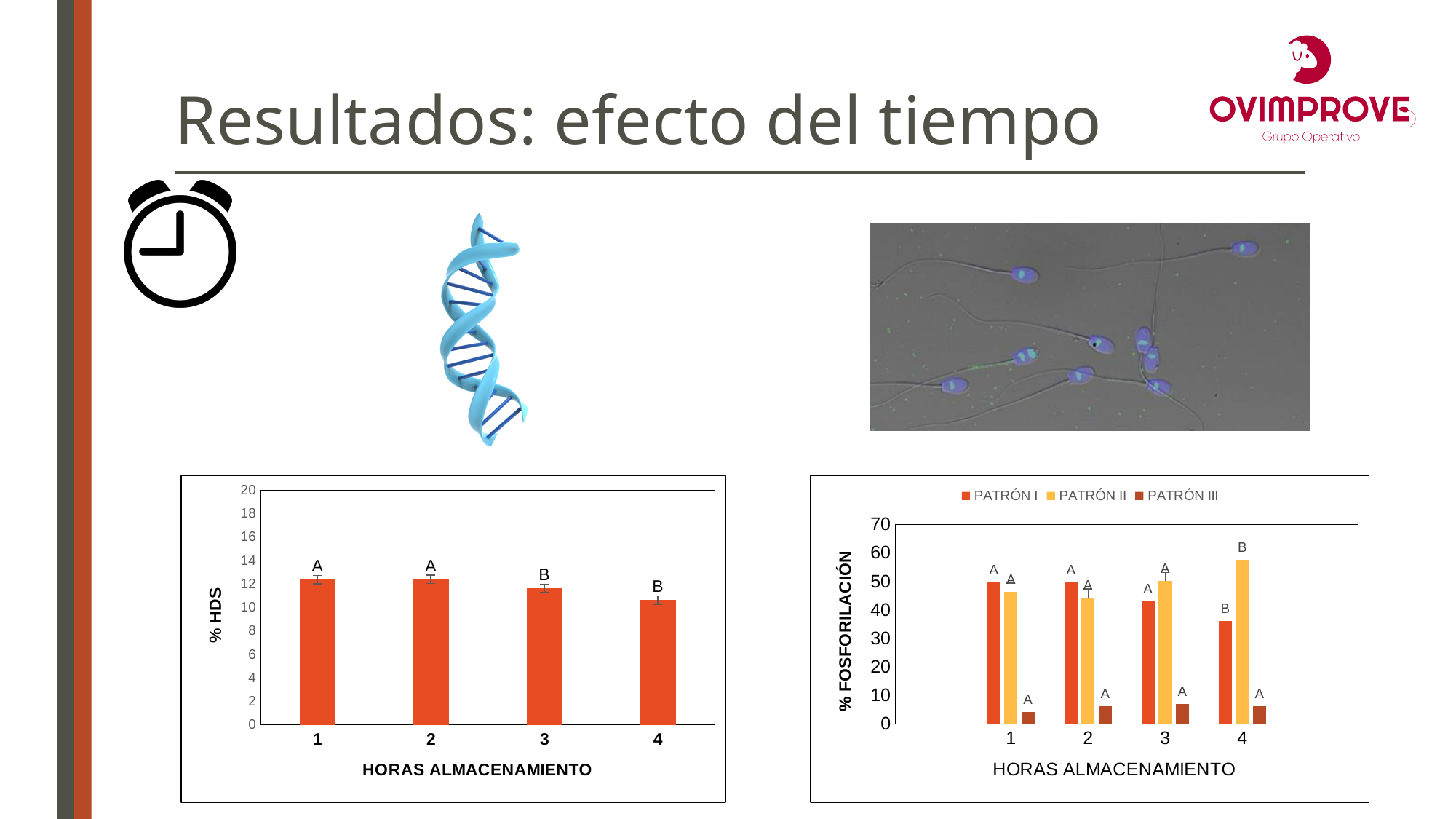
In the left chart (% HDS), is the value for hour 4 greater or less than 12? less What is the x axis title of the right chart (% FOSFORILACIÓN)? HORAS ALMACENAMIENTO How many series does the legend of the right chart (% FOSFORILACIÓN) list? 3 In the left chart (% HDS), which storage hour has the lowest value? 4 In the left chart (% HDS), is the value for hour 1 greater or less than 14? less How many categories are shown on the x axis of the left chart (% HDS)? 4 In the right chart (% FOSFORILACIÓN), at hour 4, which is larger: PATRÓN I or PATRÓN II? PATRÓN II What kind of chart is the left chart with the y axis labelled % HDS? bar chart In the right chart (% FOSFORILACIÓN), is the value for PATRÓN III at hour 1 greater or less than 10? less In the left chart (% HDS), do the values generally rise or fall as storage hours increase? fall In the right chart (% FOSFORILACIÓN), at which storage hour is PATRÓN I lowest? 4 In the right chart (% FOSFORILACIÓN), at which storage hour is PATRÓN II highest? 4